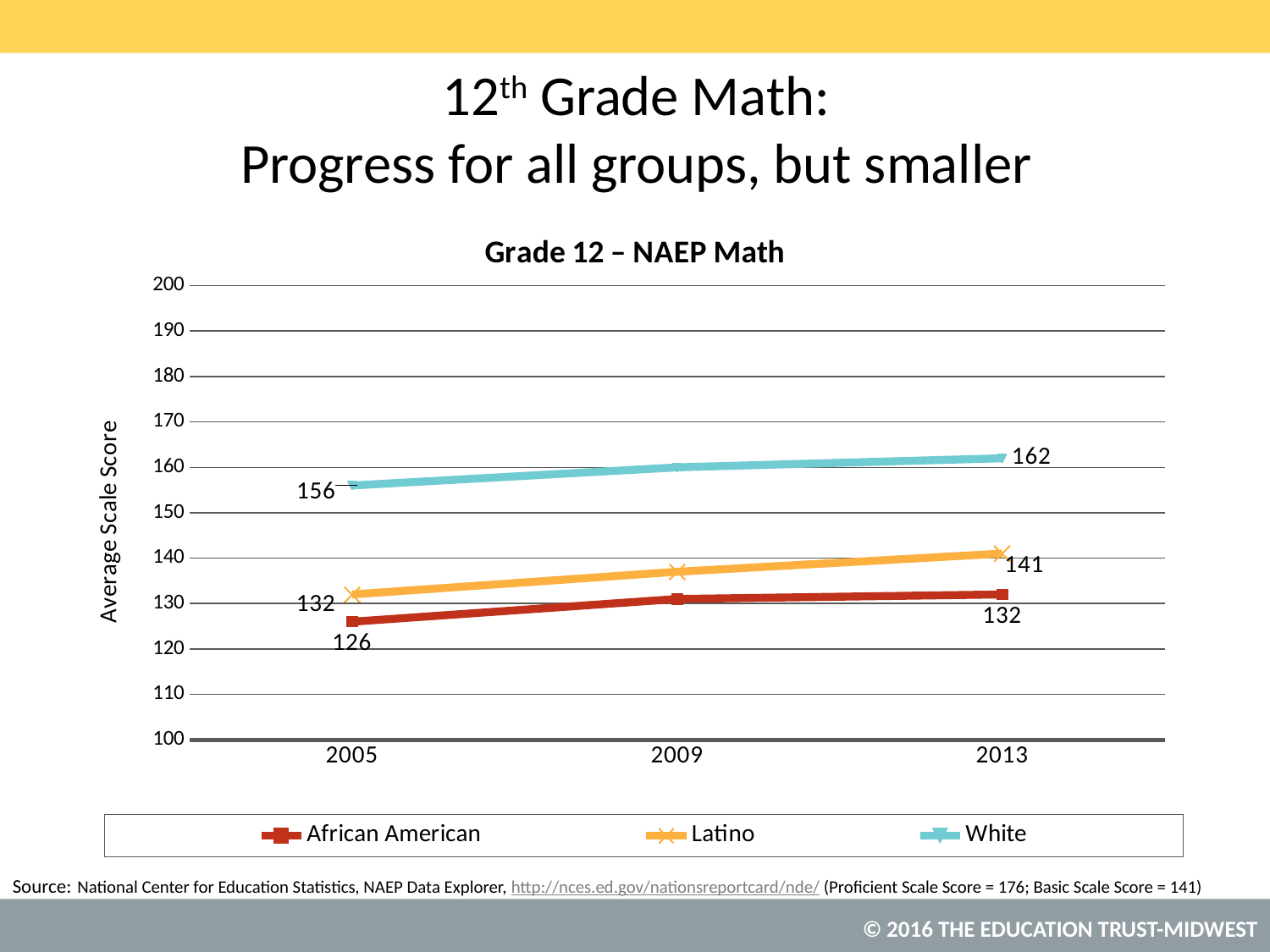
What is the difference between the Latino and African American average scale scores in 2013? 9 By how many points did the White students' average scale score increase from 2005 to 2013? 6 Is the Latino average scale score in 2009 greater or less than 140? less Which group had the highest average scale score in 2013? White Does the African American average scale score rise or fall from 2005 to 2013? Rise What was the average scale score for African American students in 2013? 132 Which group had the lowest average scale score in 2005? African American What was the average scale score for African American students in 2005? 126 What was the average scale score for White students in 2005? 156 What was the average scale score for Latino students in 2013? 141 What kind of chart is shown on the slide? Line chart How many series does the legend list? 3